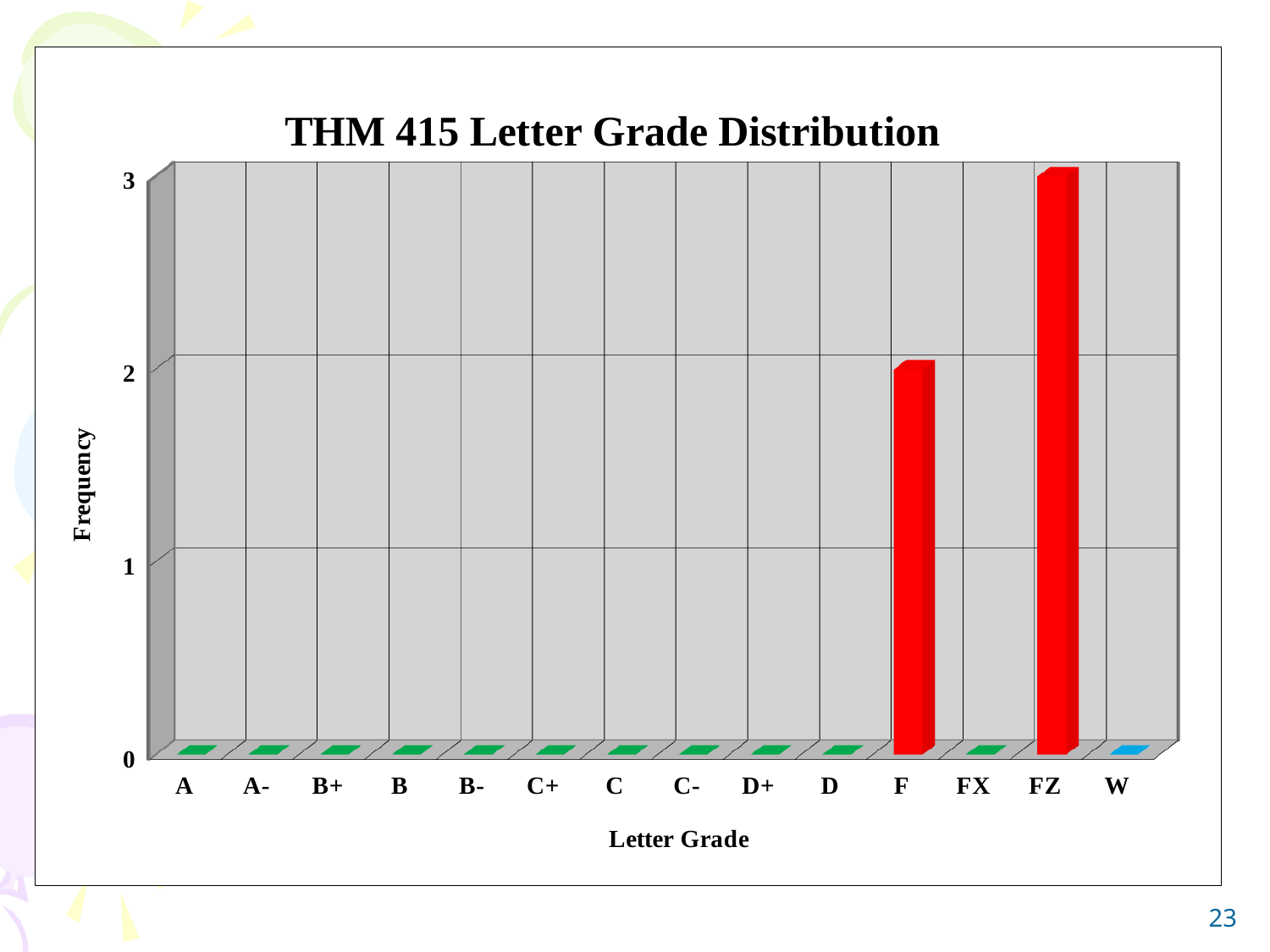
What is the frequency for the FZ letter grade? 3 What kind of chart is shown on the slide? bar chart Which letter grade has the highest frequency? FZ What is the frequency for the F letter grade? 2 What is the frequency for the W letter grade? 0 What is the frequency for the A letter grade? 0 What is the label of the y axis? Frequency How many letter grade categories are shown on the x axis? 14 Is the frequency for FZ greater or less than 2? greater What is the title of the chart? THM 415 Letter Grade Distribution What is the difference in frequency between FZ and F? 1 Which has a higher frequency, F or FZ? FZ